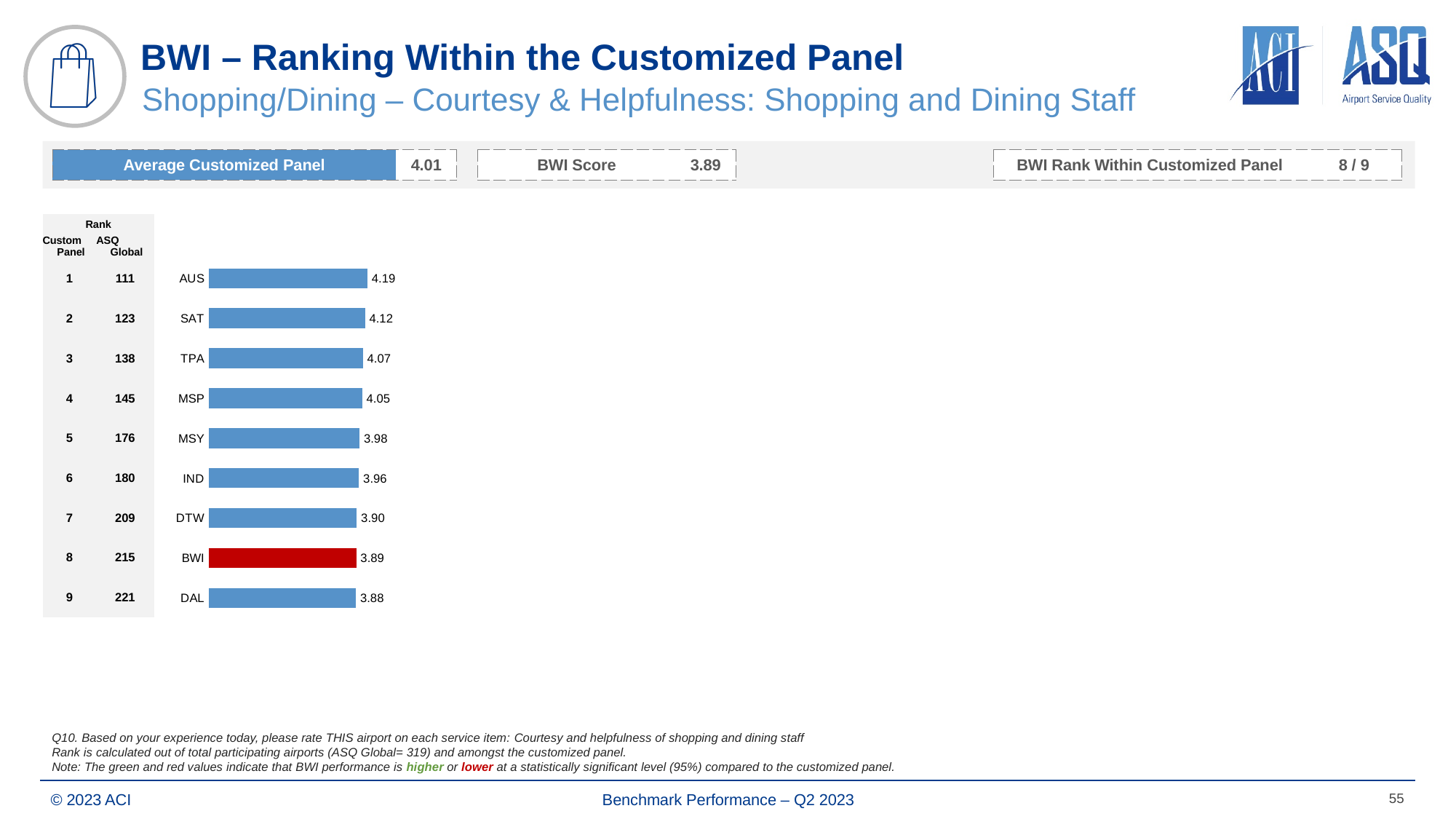
Which is larger, the value for MSP or the value for IND? MSP Which airport has the lowest value? DAL What kind of chart is shown on the slide? bar chart What is the difference between the values for SAT and TPA? 0.05 What is the difference between the values for AUS and BWI? 0.30 Which airport's bar is coloured red? BWI Which airport has the highest value? AUS How many airports are shown in the chart? 9 What is the value for MSY? 3.98 Do the values rise or fall going from the top bar to the bottom bar? fall What is the value for AUS? 4.19 What is the value for BWI? 3.89